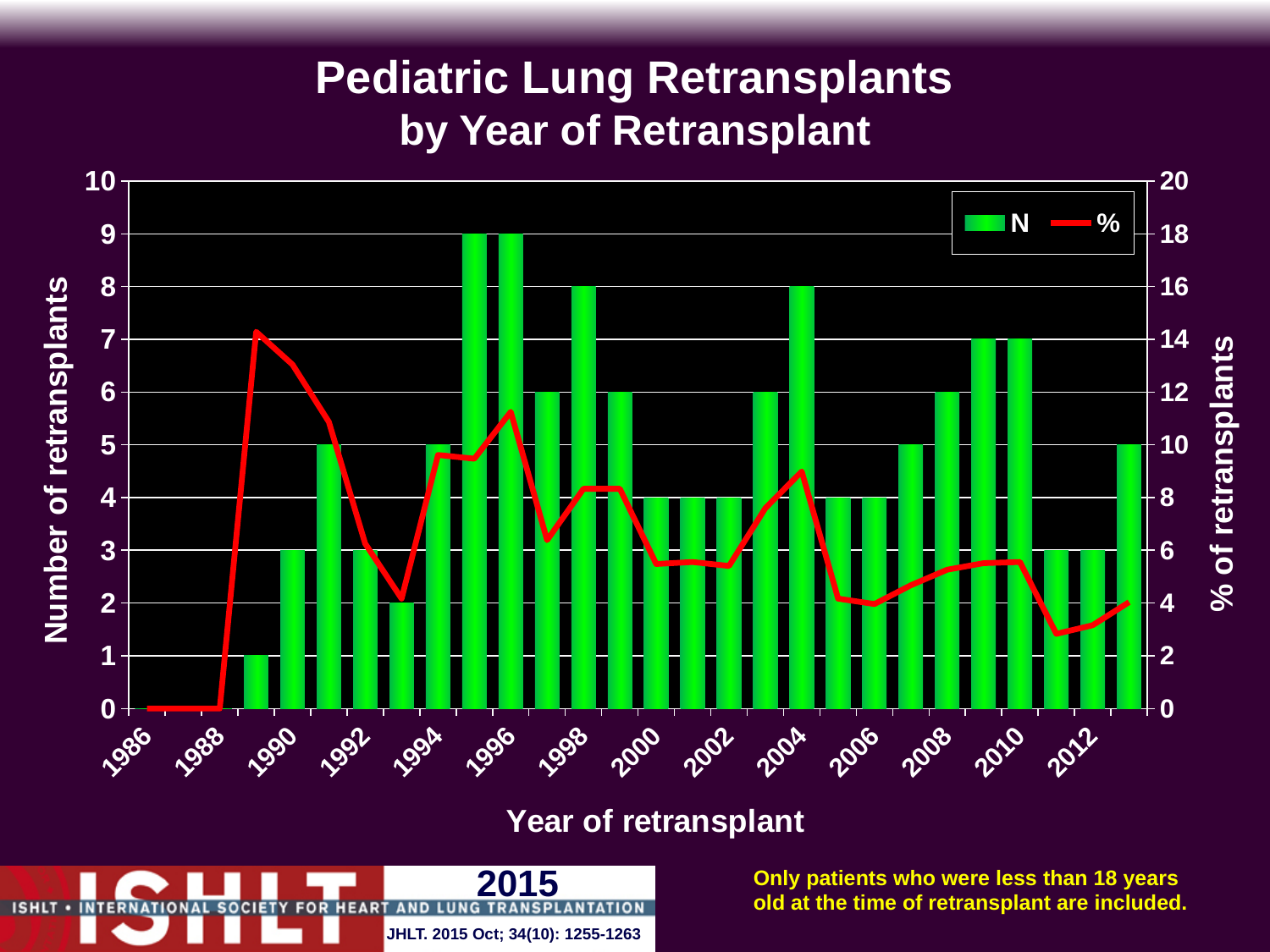
Is the peak value of the % line greater or less than 12? greater What is the number of retransplants (N) in 1996? 9 What is the number of retransplants (N) in 2010? 7 How many series does the legend list? 2 Which year had more retransplants, 1996 or 2000? 1996 What is the number of retransplants (N) in 2004? 8 What is the number of retransplants (N) in 2012? 3 What is the title of the left vertical axis? Number of retransplants What kind of chart is shown on the slide? A bar chart combined with a line What is the difference in the number of retransplants between 1998 and 2006? 4 What is the number of retransplants (N) in 1998? 8 What is the highest number of retransplants (N) reached by any bar? 9